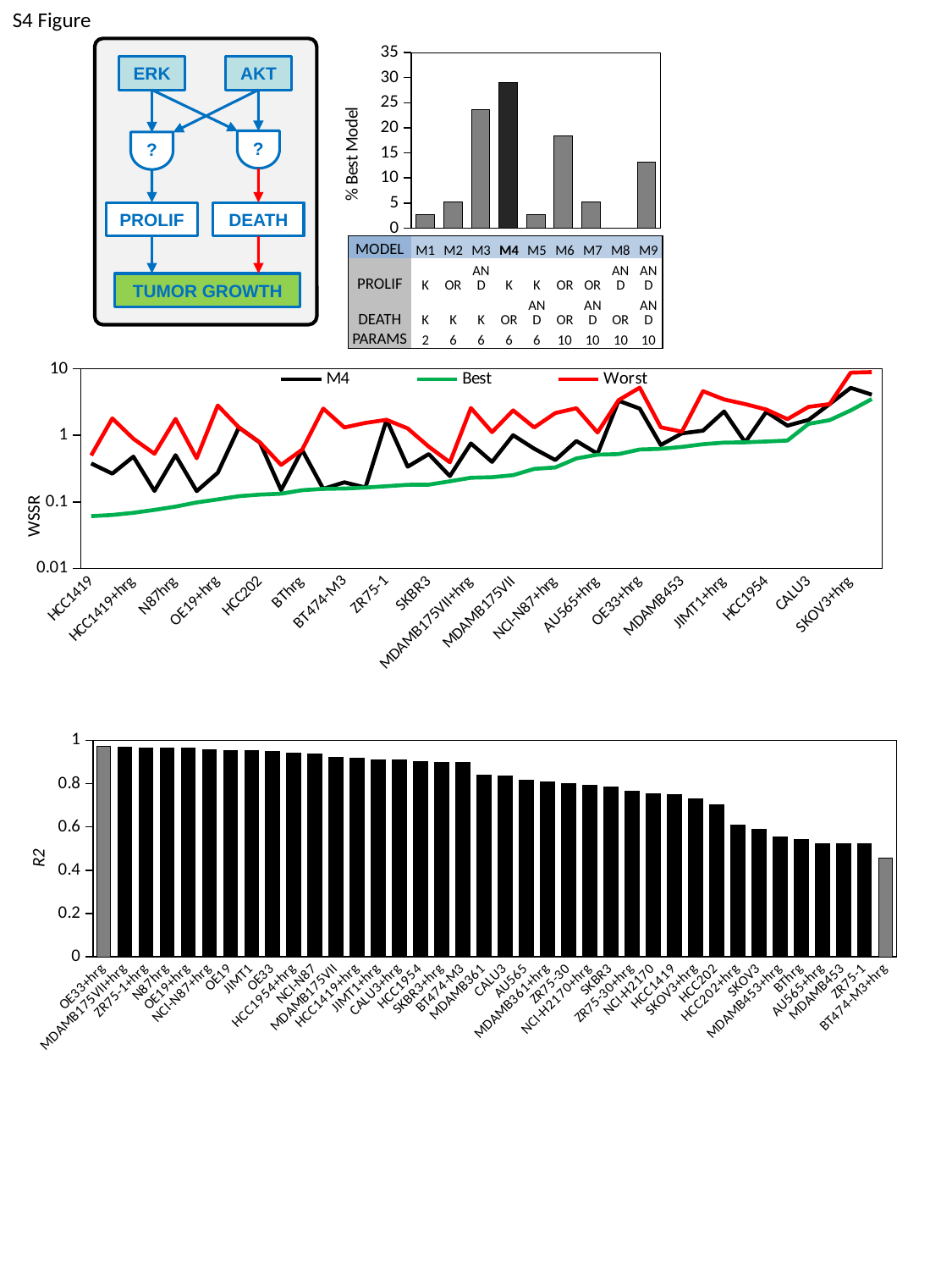
What kind of chart is the % Best Model chart at the top right? bar chart In the R2 bar chart at the bottom, is the value for HCC202 greater or less than 0.6? greater In the % Best Model bar chart at the top right, is the value for M4 greater or less than 25? greater In the WSSR chart in the middle, what colour is the Worst series line? red In the % Best Model bar chart at the top right, is the value for M6 greater or less than 20? less What kind of chart is the WSSR chart in the middle? line chart In the % Best Model bar chart at the top right, which is larger, the value for M3 or the value for M6? M3 In the % Best Model bar chart at the top right, which model has the highest percentage? M4 In the WSSR chart in the middle, how many series does the legend list? 3 In the WSSR chart in the middle, does the Best series rise or fall from left to right along the x axis? rise In the % Best Model bar chart at the top right, how many models are listed on the x axis? 9 In the R2 bar chart at the bottom, which cell line has the lowest R2 value? BT474-M3+hrg